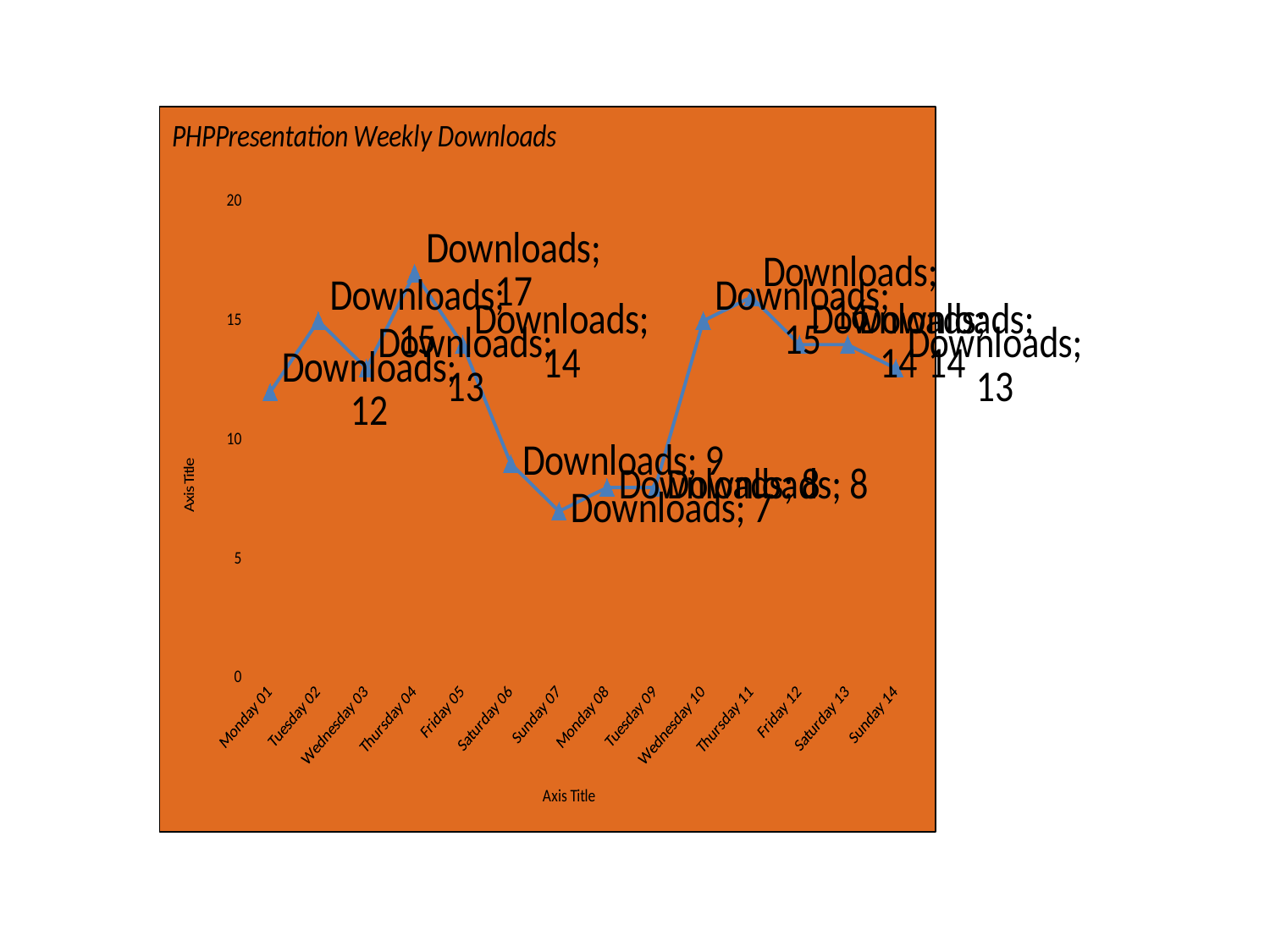
What is the difference between the Downloads on Thursday 04 and Sunday 07? 10 How many days are plotted along the x axis? 14 What is the Downloads value for Monday 01? 12 What is the Downloads value for Thursday 04? 17 Which day has the lowest Downloads value? Sunday 07 Is the Downloads value for Saturday 06 greater or less than 10? less What kind of chart is shown on the slide? line chart What is the title of the chart? PHPPresentation Weekly Downloads What is the Downloads value for Sunday 07? 7 What is the Downloads value for Saturday 06? 9 Do the Downloads values rise or fall from Thursday 04 to Sunday 07? fall Which day has the highest Downloads value? Thursday 04